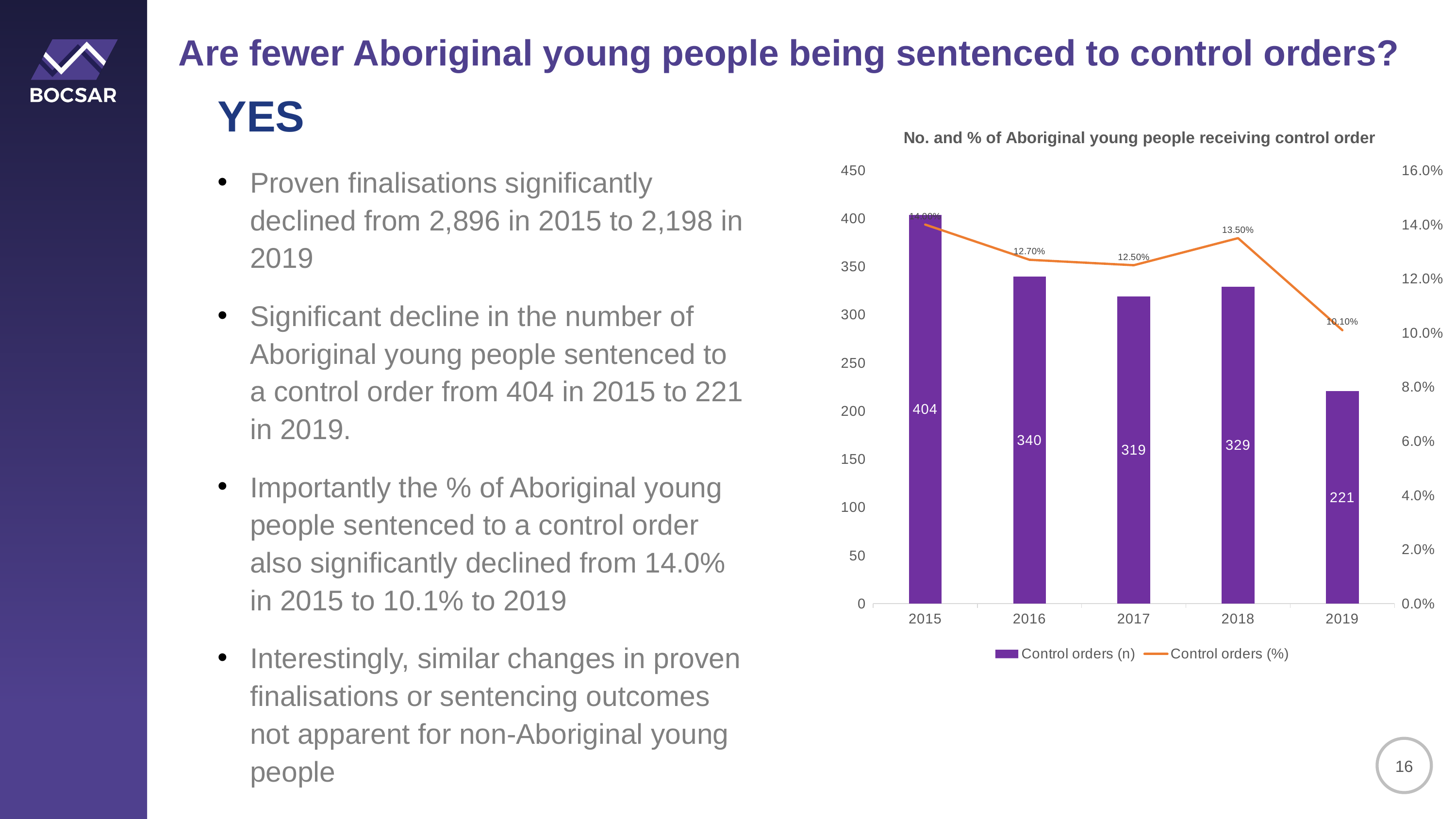
Which year has the highest number of control orders? 2015 Which year has the lowest number of control orders? 2019 Which year had more control orders, 2017 or 2018? 2018 How many series does the chart legend list? 2 What is the value of Control orders (n) for 2019? 221 How many years are shown on the x axis of the chart? 5 By how much did Control orders (n) fall from 2015 to 2019? 183 What is the Control orders (%) value shown for 2018? 13.50% How many Aboriginal young people received a control order in 2015 according to the chart? 404 What is the difference in Control orders (n) between 2016 and 2017? 21 Does the number of control orders generally rise or fall from 2015 to 2019? fall What is the Control orders (%) value shown for 2019? 10.10%